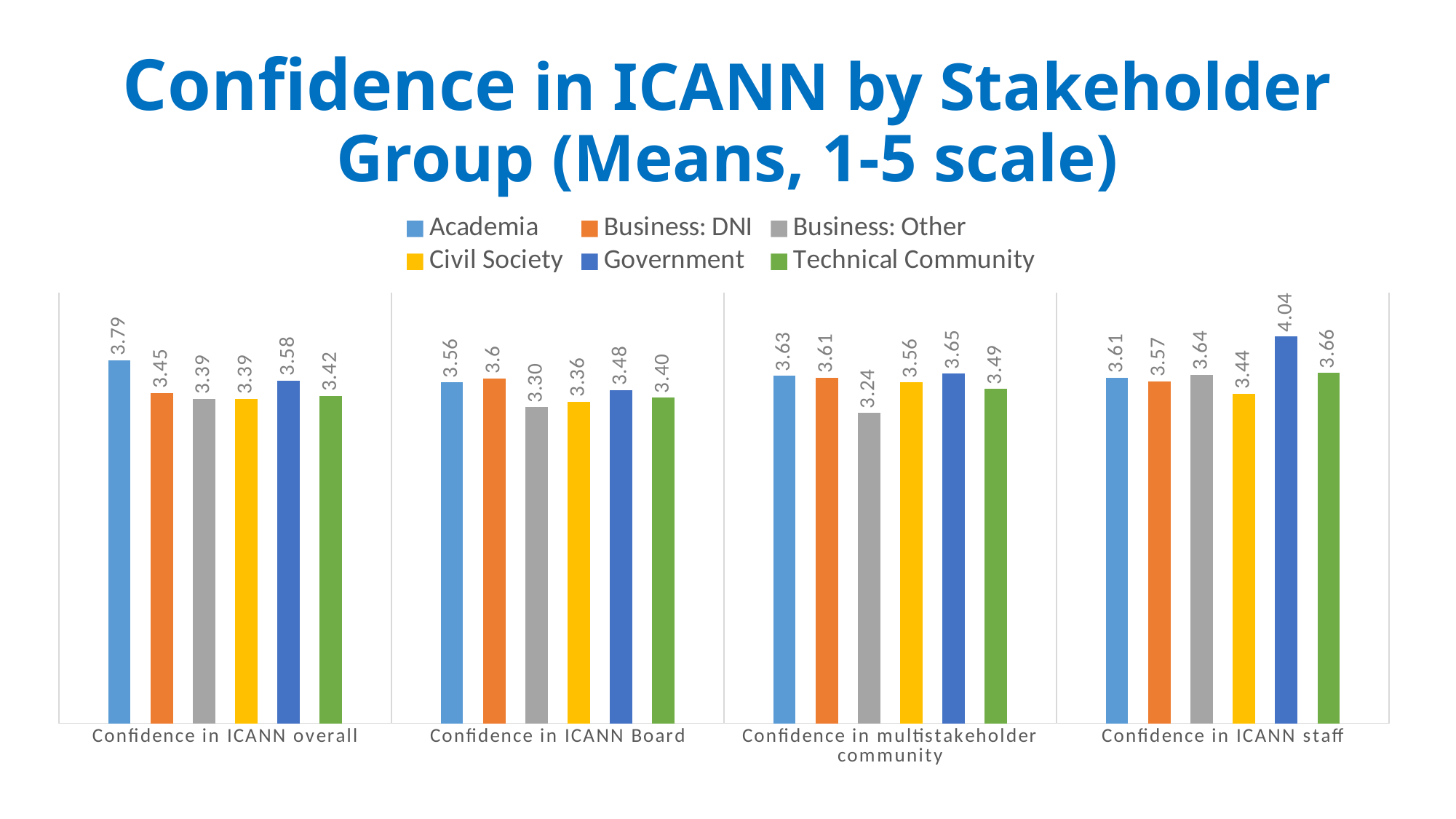
For Confidence in ICANN Board, which is larger: the Academia value or the Business: Other value? Academia Which stakeholder group has the lowest value for Confidence in multistakeholder community? Business: Other What is the mean confidence in ICANN overall for Academia? 3.79 How many categories are shown on the x axis? 4 How many series does the legend list? 6 What is the Business: Other value for Confidence in multistakeholder community? 3.24 What is the Government value for Confidence in ICANN staff? 4.04 Which stakeholder group has the highest value for Confidence in ICANN staff? Government What is the difference between the Government and Civil Society values for Confidence in ICANN staff? 0.60 What is the Business: DNI value for Confidence in ICANN Board? 3.6 What is the difference between the Academia and Business: DNI values for Confidence in ICANN overall? 0.34 What kind of chart is shown on the slide? Bar chart